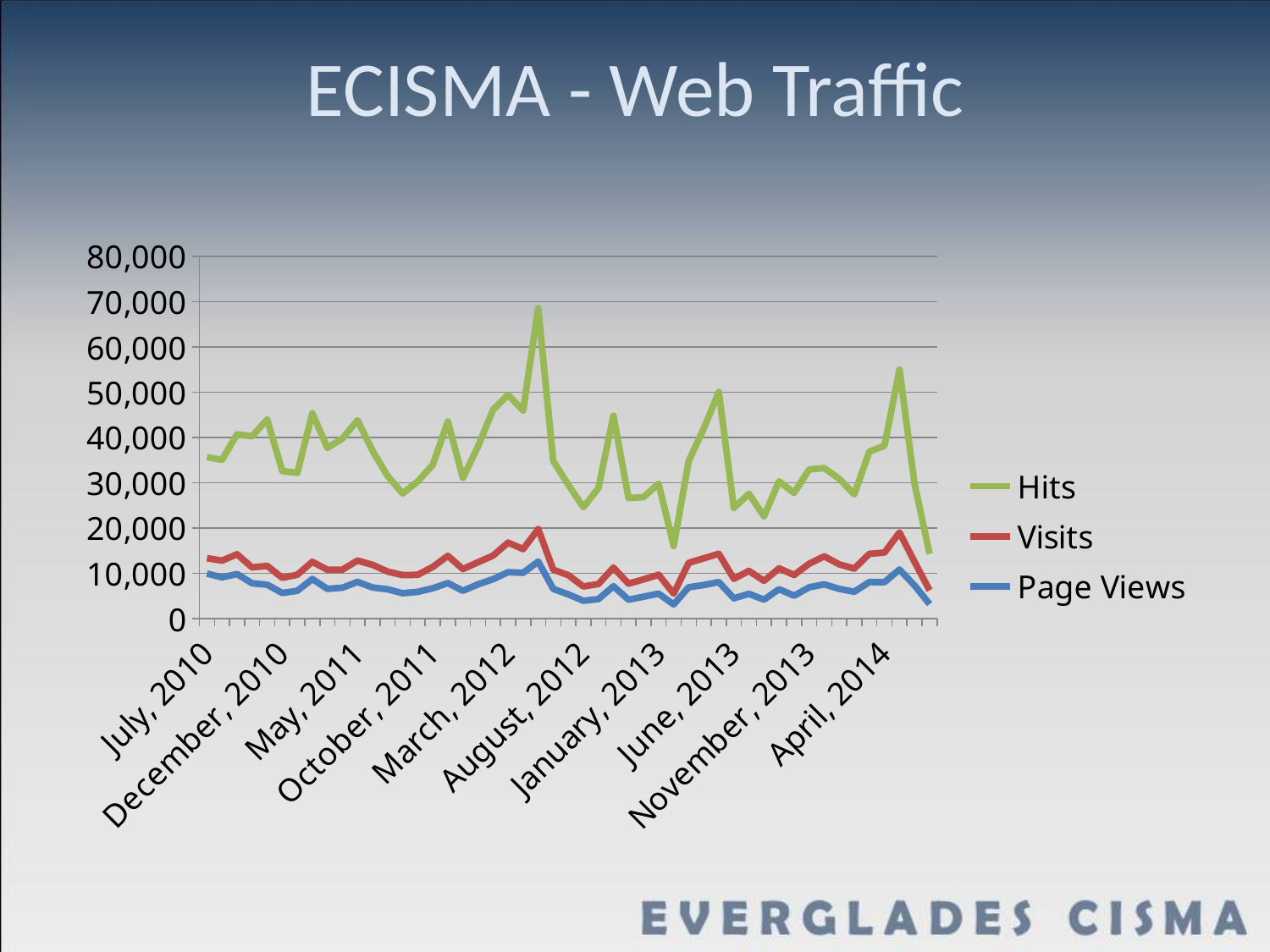
Which series is drawn with the green line? Hits How many series does the legend list? 3 What kind of chart is shown on the slide? line chart Which series has the lowest values across the whole period? Page Views Is the value for Page Views in August, 2012 greater or less than 10,000? less In July, 2010, which is larger: Hits or Visits? Hits How many month labels are shown on the x axis? 10 Is the value for Hits in July, 2010 greater or less than 30,000? greater Is the value for Visits in July, 2010 greater or less than 10,000? greater What is the title of the chart? ECISMA - Web Traffic Which series has the highest values across the whole period? Hits